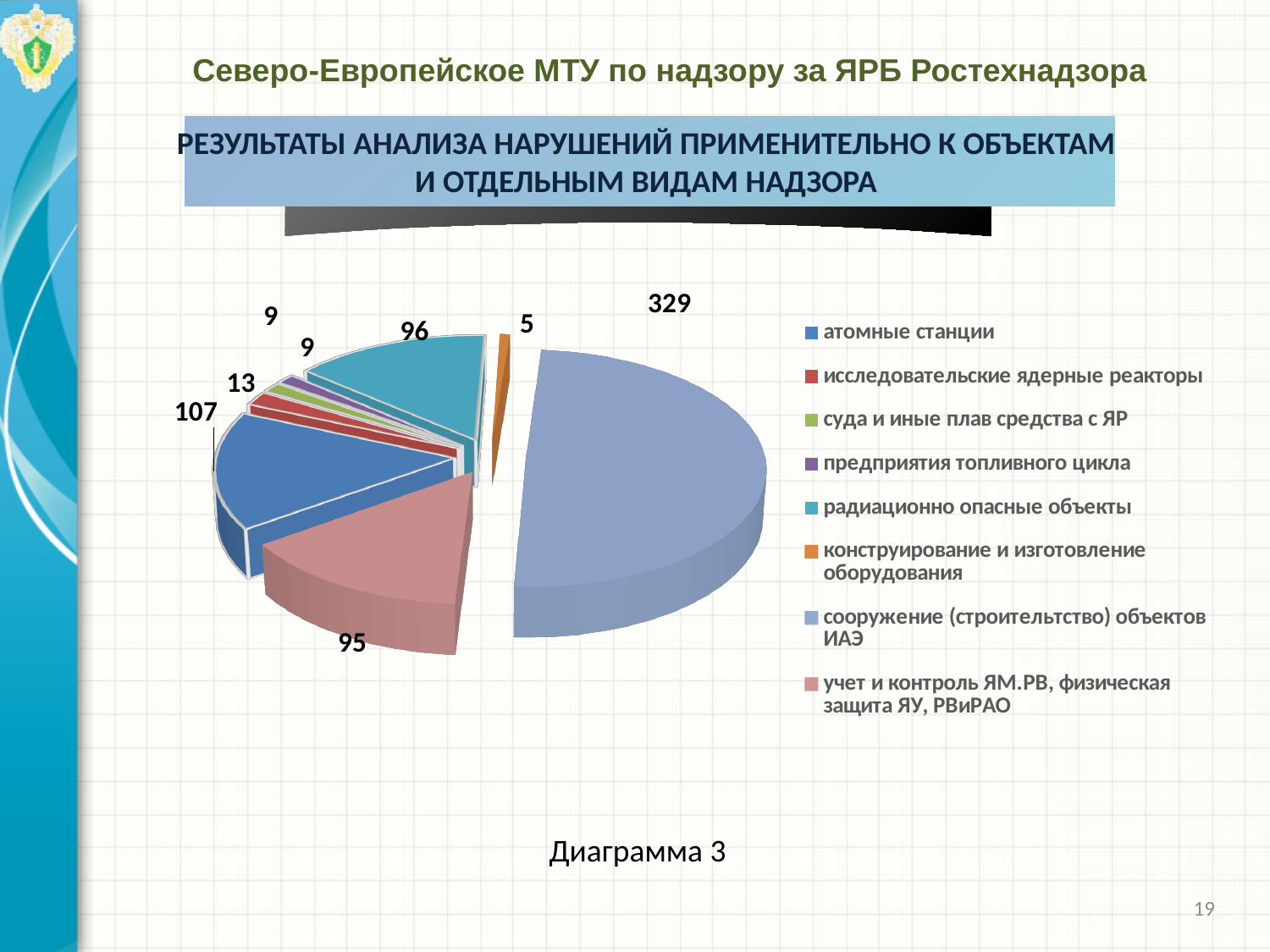
What is the value for «конструирование и изготовление оборудования»? 5 What kind of chart is shown on the slide? pie chart What is the value for «радиационно опасные объекты»? 96 What is the value for «исследовательские ядерные реакторы»? 13 What is the value for «учет и контроль ЯМ.РВ, физическая защита ЯУ, РВиРАО»? 95 Which is larger: the value for «атомные станции» or for «учет и контроль ЯМ.РВ, физическая защита ЯУ, РВиРАО»? атомные станции Which category has the smallest slice of the pie? конструирование и изготовление оборудования Which category has the largest slice of the pie? сооружение (строительство) объектов ИАЭ What is the value for «атомные станции»? 107 What is the difference between the values for «сооружение (строительство) объектов ИАЭ» and «атомные станции»? 222 What is the value for «сооружение (строительство) объектов ИАЭ»? 329 How many categories does the legend list? 8